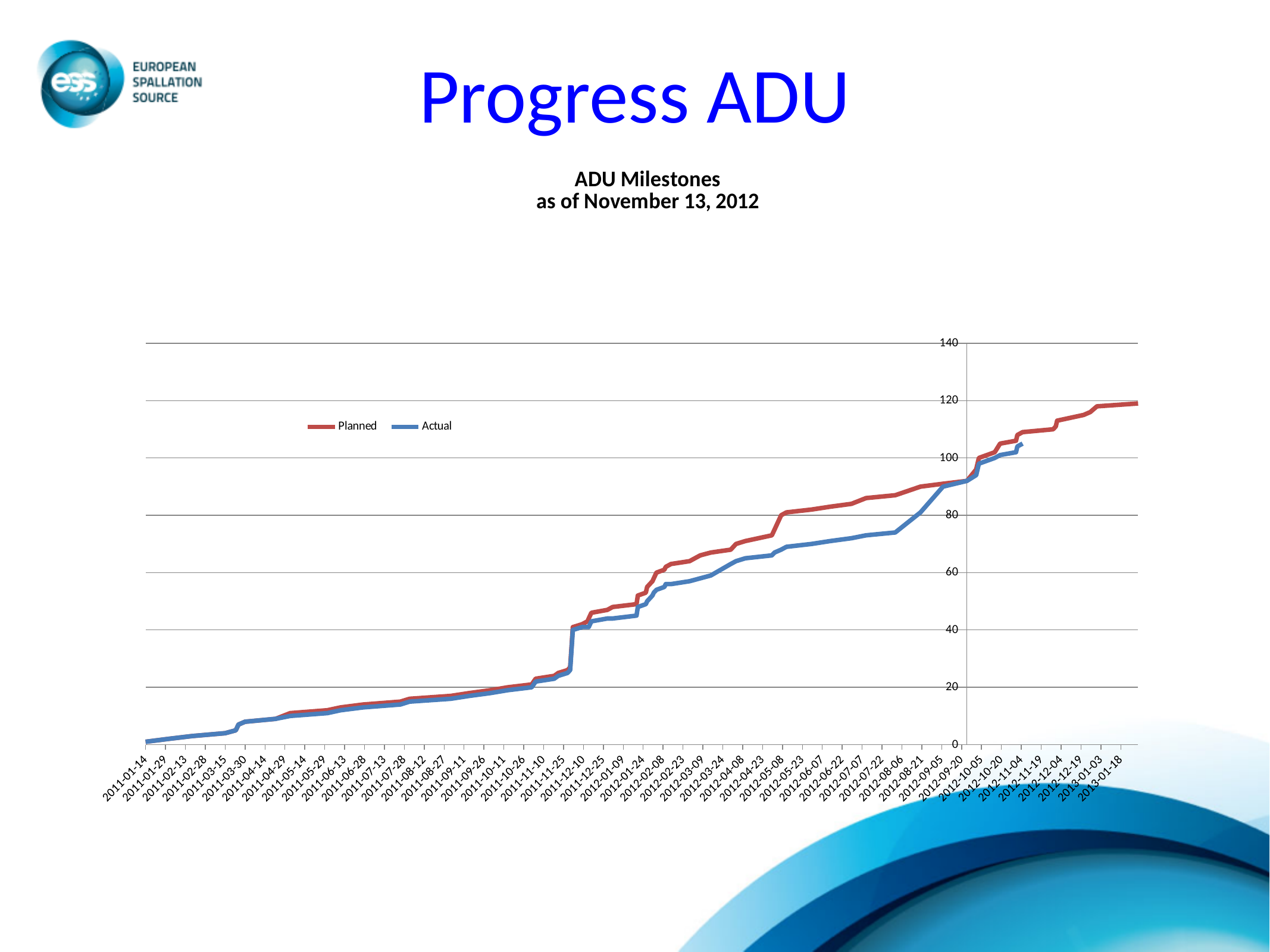
At 2012-05-08, which series has the higher value, Planned or Actual? Planned Is the Planned value at 2013-01-18 greater or less than 100? greater What kind of chart is shown on the slide? Line chart What are the two series named in the legend? Planned and Actual Do the Planned values rise or fall along the x axis from 2011-01-14 to 2013-01-18? Rise Is the Actual value at 2012-08-06 greater or less than 80? less What is the title of the chart? ADU Milestones as of November 13, 2012 Is the Actual value at 2012-02-08 greater or less than 60? less At 2012-08-06, which series has the higher value, Planned or Actual? Planned Do the Actual values rise or fall over time? Rise How many series does the legend list? 2